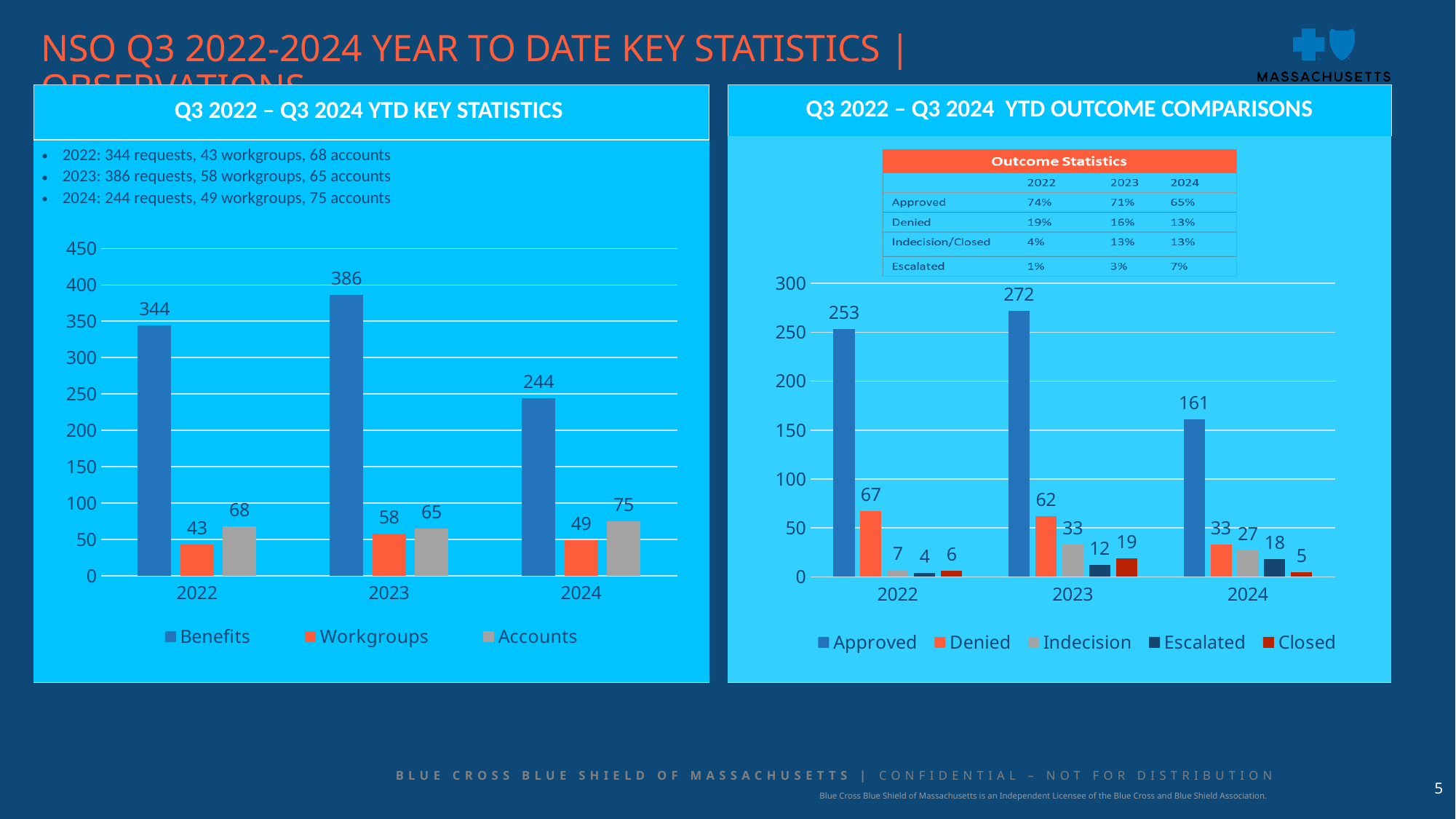
In the Q3 2022 – Q3 2024 YTD Key Statistics chart, how many series does the legend list? 3 In the Q3 2022 – Q3 2024 YTD Key Statistics chart, what is the value for Accounts in 2024? 75 In the Q3 2022 – Q3 2024 YTD Outcome Comparisons chart, which is larger, the Denied value for 2022 or the Denied value for 2023? 2022 In the Q3 2022 – Q3 2024 YTD Outcome Comparisons chart, how does the Approved value change from 2023 to 2024? It falls In the Q3 2022 – Q3 2024 YTD Key Statistics chart, which year has the highest Benefits value? 2023 In the Q3 2022 – Q3 2024 YTD Outcome Comparisons chart, which year has the lowest Approved value? 2024 In the Q3 2022 – Q3 2024 YTD Key Statistics chart, is the Workgroups value for 2022 greater or less than 50? less In the Q3 2022 – Q3 2024 YTD Key Statistics chart, what is the difference between the Benefits values for 2023 and 2024? 142 What kind of chart is the Q3 2022 – Q3 2024 YTD Outcome Comparisons chart? Bar chart In the Q3 2022 – Q3 2024 YTD Outcome Comparisons chart, what is the Approved value for 2024? 161 In the Q3 2022 – Q3 2024 YTD Key Statistics chart, what is the value for Benefits in 2023? 386 In the Q3 2022 – Q3 2024 YTD Outcome Comparisons chart, what is the Closed value for 2023? 19